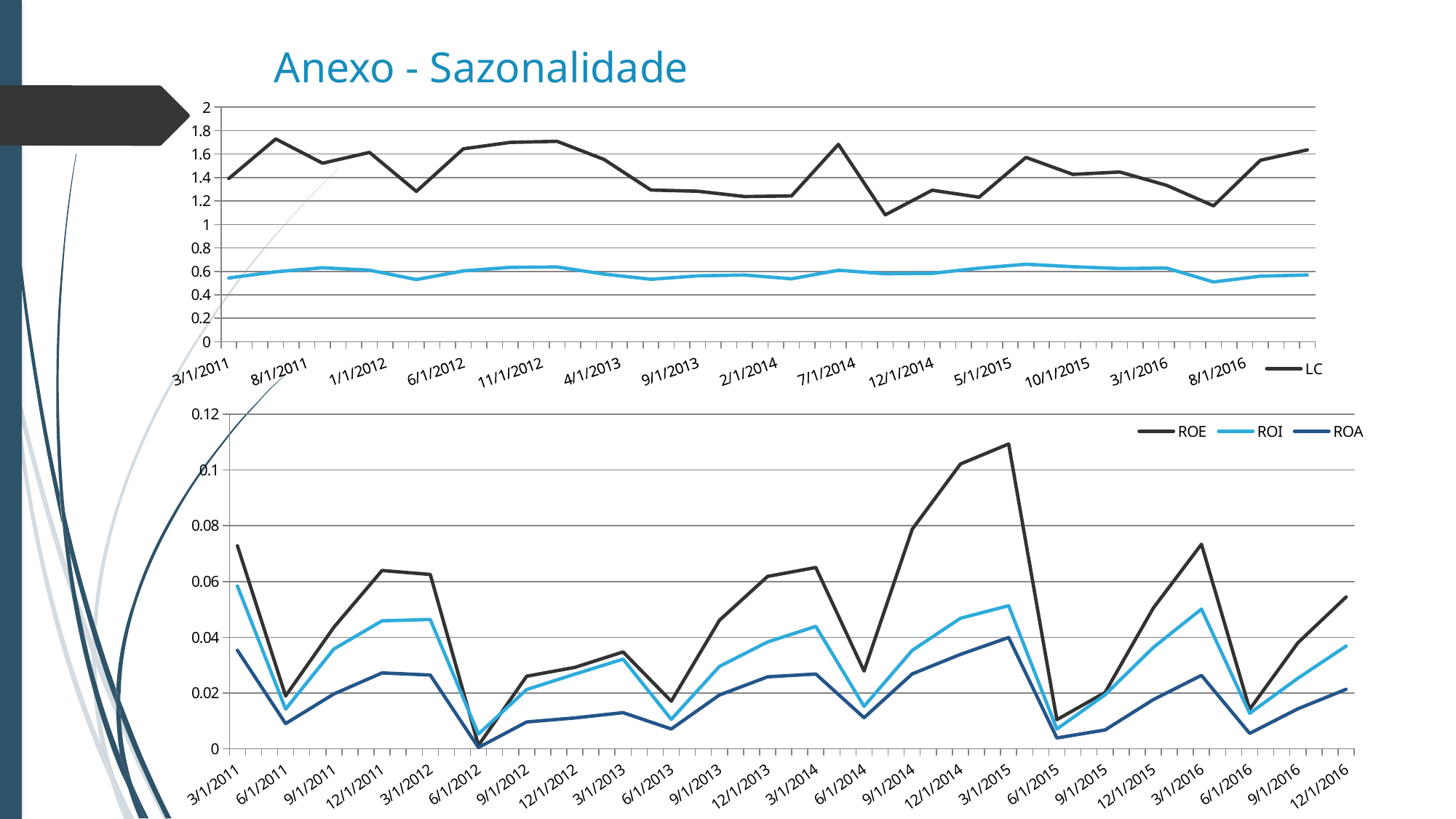
In the bottom chart, is the value of ROE at 6/1/2012 greater or less than 0.02? less How many series does the legend of the bottom chart list? 3 Which series are listed in the legend of the bottom chart? ROE, ROI, ROA In the bottom chart, is the value of ROE at 3/1/2015 greater or less than 0.1? greater What is the title of the slide containing the two charts? Anexo - Sazonalidade What kind of chart is the bottom chart (ROE, ROI, ROA)? line chart In the bottom chart, at which date does ROE reach its lowest value? 6/1/2012 In the top chart, is the value of LC at 7/1/2014 greater or less than 1.6? greater In the bottom chart, which is larger at 3/1/2011: ROI or ROA? ROI In the bottom chart, does ROE rise or fall between 9/1/2014 and 3/1/2015? rise In the bottom chart, at which date does ROE reach its highest value? 3/1/2015